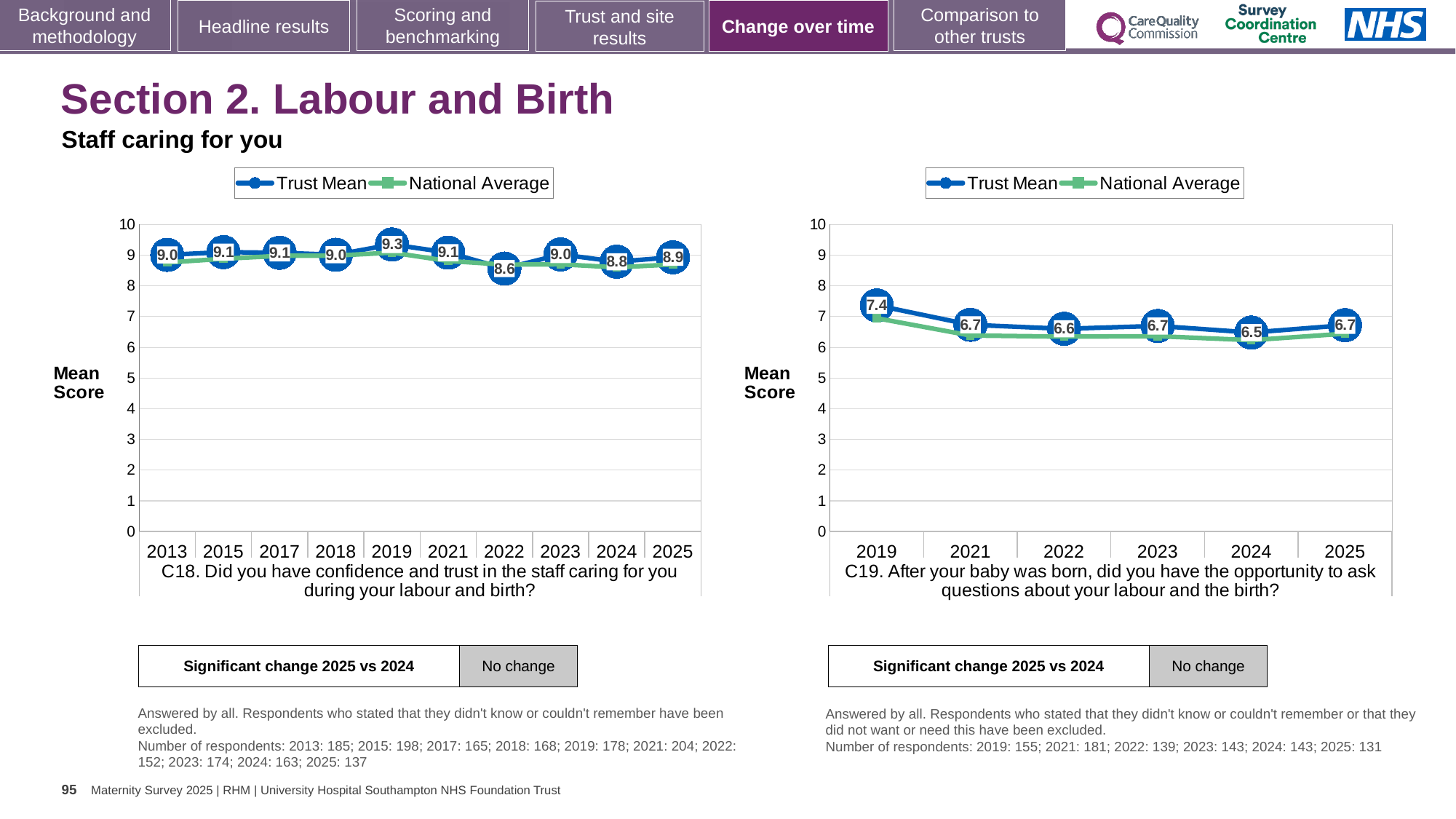
In the C18 chart on the left, what is the difference between the Trust Mean scores for 2019 and 2022? 0.7 How many series does the legend of the C19 chart on the right list? 2 In the C18 chart on the left, how many years are plotted on the x axis? 10 In the C18 chart on the left, what is the Trust Mean score for 2022? 8.6 What kind of chart is the C18 chart on the left? Line chart In the C18 chart on the left, what is the Trust Mean score for 2019? 9.3 In the C18 chart on the left, which year has the lowest Trust Mean score? 2022 In the C19 chart on the right, which year has the lowest Trust Mean score? 2024 In the C18 chart on the left, which year has the highest Trust Mean score? 2019 In the C19 chart on the right, what is the Trust Mean score for 2019? 7.4 In the C19 chart on the right, what is the difference between the Trust Mean scores for 2019 and 2025? 0.7 In the C19 chart on the right, is the Trust Mean score for 2019 greater or less than 7? greater